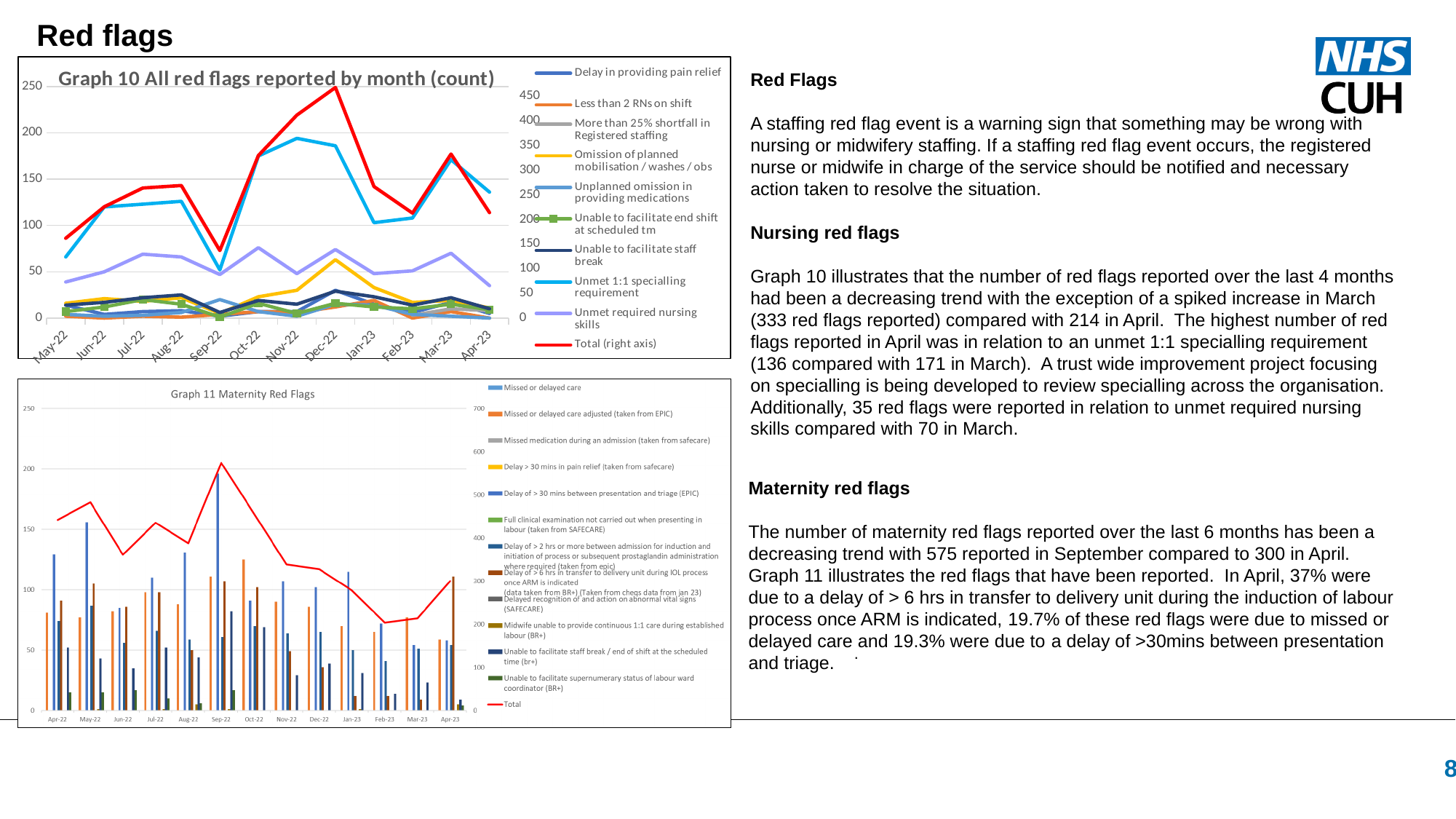
In Graph 10 All red flags reported by month (count), which is larger for the Total (right axis) line: Dec-22 or Jan-23? Dec-22 How many months are shown on the x axis of Graph 10 All red flags reported by month (count)? 12 What kind of chart is Graph 11 Maternity Red Flags (excluding the Total line)? bar chart In Graph 11 Maternity Red Flags, in which month does the Total line reach its highest value? Sep-22 How many months are shown on the x axis of Graph 11 Maternity Red Flags? 13 In Graph 10 All red flags reported by month (count), in which month does the Total (right axis) line reach its highest value? Dec-22 In Graph 10 All red flags reported by month (count), is the value for Unmet 1:1 specialling requirement in Nov-22 greater or less than 150? greater How many entries does the legend of Graph 11 Maternity Red Flags list? 13 In Graph 10 All red flags reported by month (count), does the Total (right axis) line rise or fall from Sep-22 to Dec-22? rise How many entries does the legend of Graph 10 All red flags reported by month (count) list? 10 What kind of chart is Graph 10 All red flags reported by month (count)? line chart In Graph 10 All red flags reported by month (count), is the value for Unmet required nursing skills in Apr-23 greater or less than 50? less